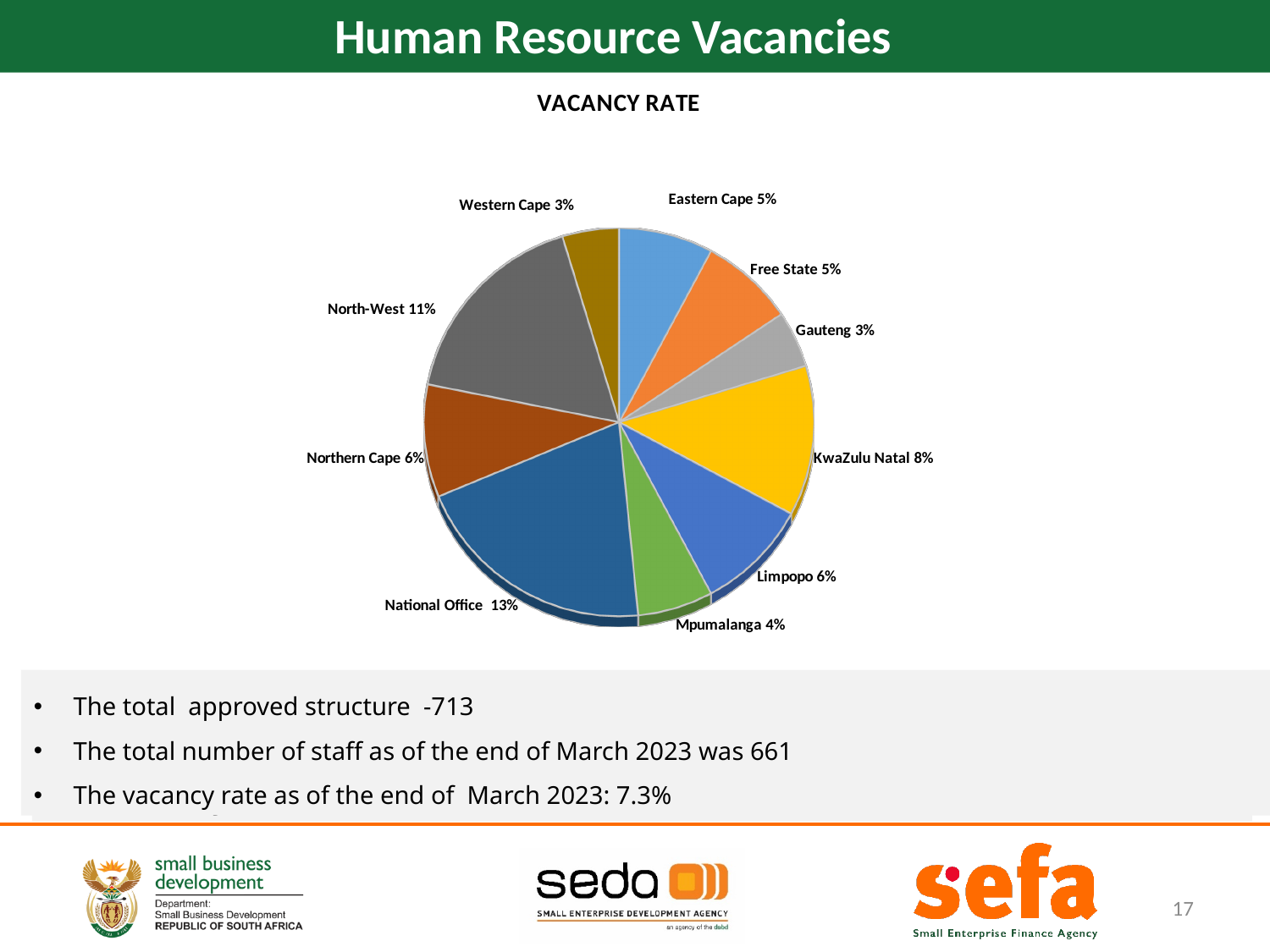
What is the vacancy rate shown for North-West? 11% How many slices does the pie chart have? 10 What is the vacancy rate shown for Western Cape? 3% Which category has the highest vacancy rate in the pie chart? National Office What is the title of the chart? VACANCY RATE What type of chart is shown on the slide? pie chart Which has a higher vacancy rate, KwaZulu Natal or Limpopo? KwaZulu Natal What is the vacancy rate shown for National Office? 13% What is the difference in percentage points between National Office and North-West? 2 What is the vacancy rate shown for Mpumalanga? 4% What is the vacancy rate shown for KwaZulu Natal? 8% Which has a higher vacancy rate, Northern Cape or Gauteng? Northern Cape